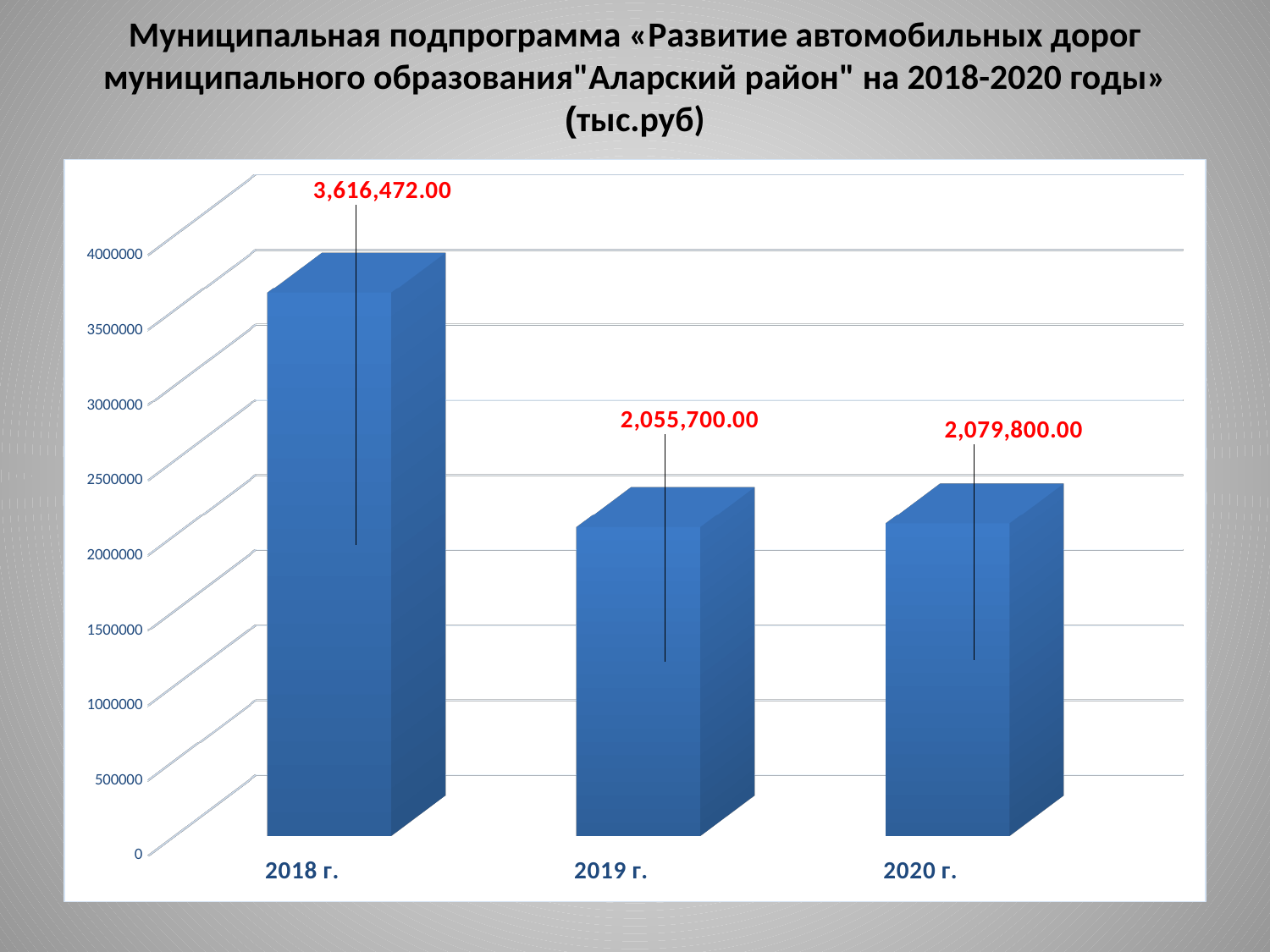
What is the value for 2020 г.? 2,079,800.00 Which year has the lowest value? 2019 г. What is the value for 2019 г.? 2,055,700.00 Is the value for 2019 г. greater or less than 2500000? less What is the difference between the values for 2020 г. and 2019 г.? 24,100.00 Which is larger, the value for 2019 г. or the value for 2020 г.? 2020 г. What is the value for 2018 г.? 3,616,472.00 What kind of chart is shown on the slide? bar chart What is the difference between the values for 2018 г. and 2019 г.? 1,560,772.00 Which year has the highest value? 2018 г. Does the value rise or fall from 2018 г. to 2019 г.? fall How many years are shown on the chart? 3